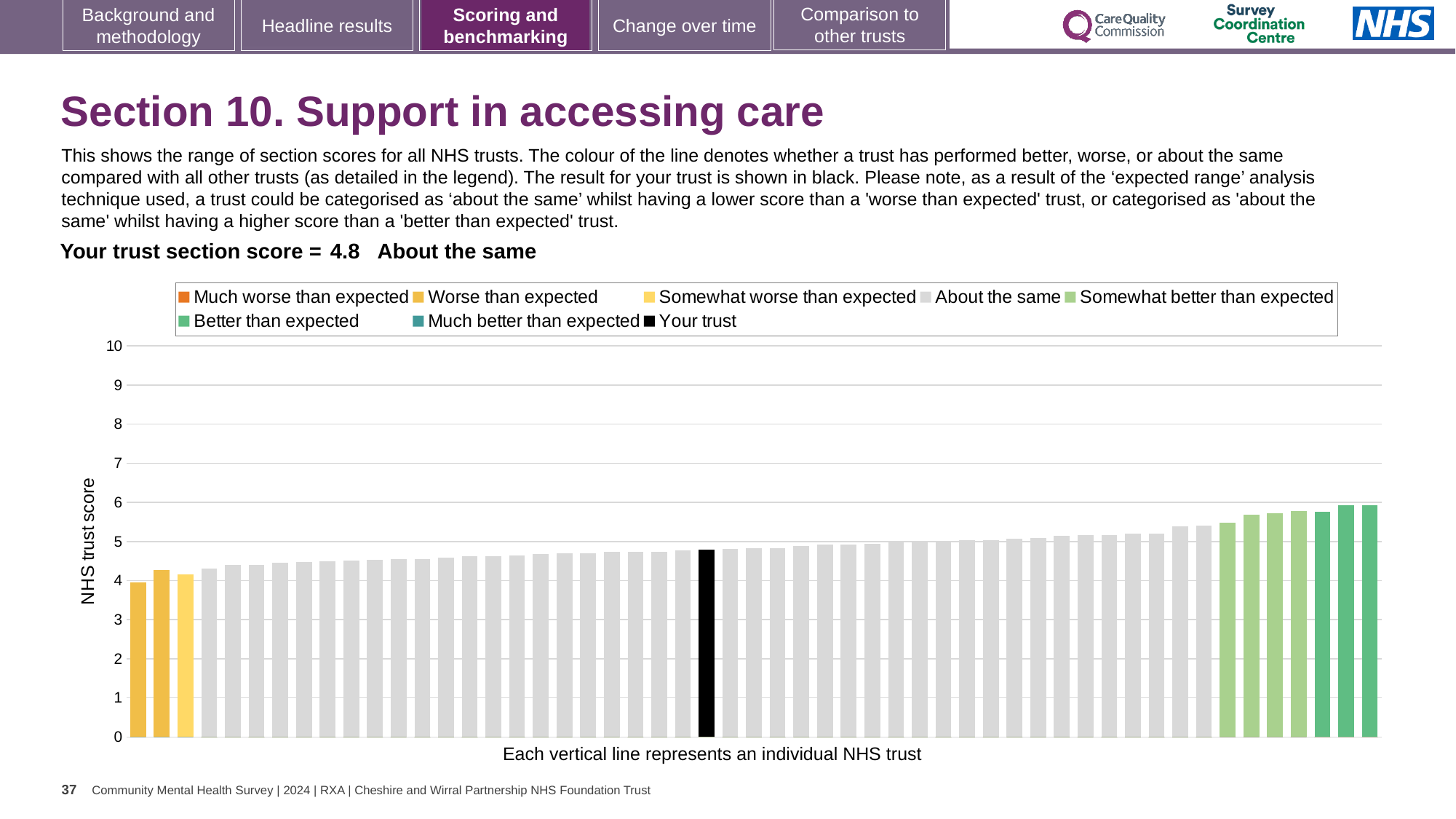
Is the black bar for your trust higher or lower than the rightmost bar? lower What kind of chart is shown on the slide? bar chart What is the label on the vertical axis of the chart? NHS trust score Is the value of the lowest bar greater or less than 5? less How many entries does the chart legend list? 8 What colour is the bar representing your trust? black Which performance category is your trust placed in according to the slide? About the same Do the bar values rise or fall from left to right along the x axis? rise Is the value for your trust (the black bar) greater or less than 5? less What is the section score for your trust shown on the slide? 4.8 Is the value of the highest bar greater or less than 5? greater